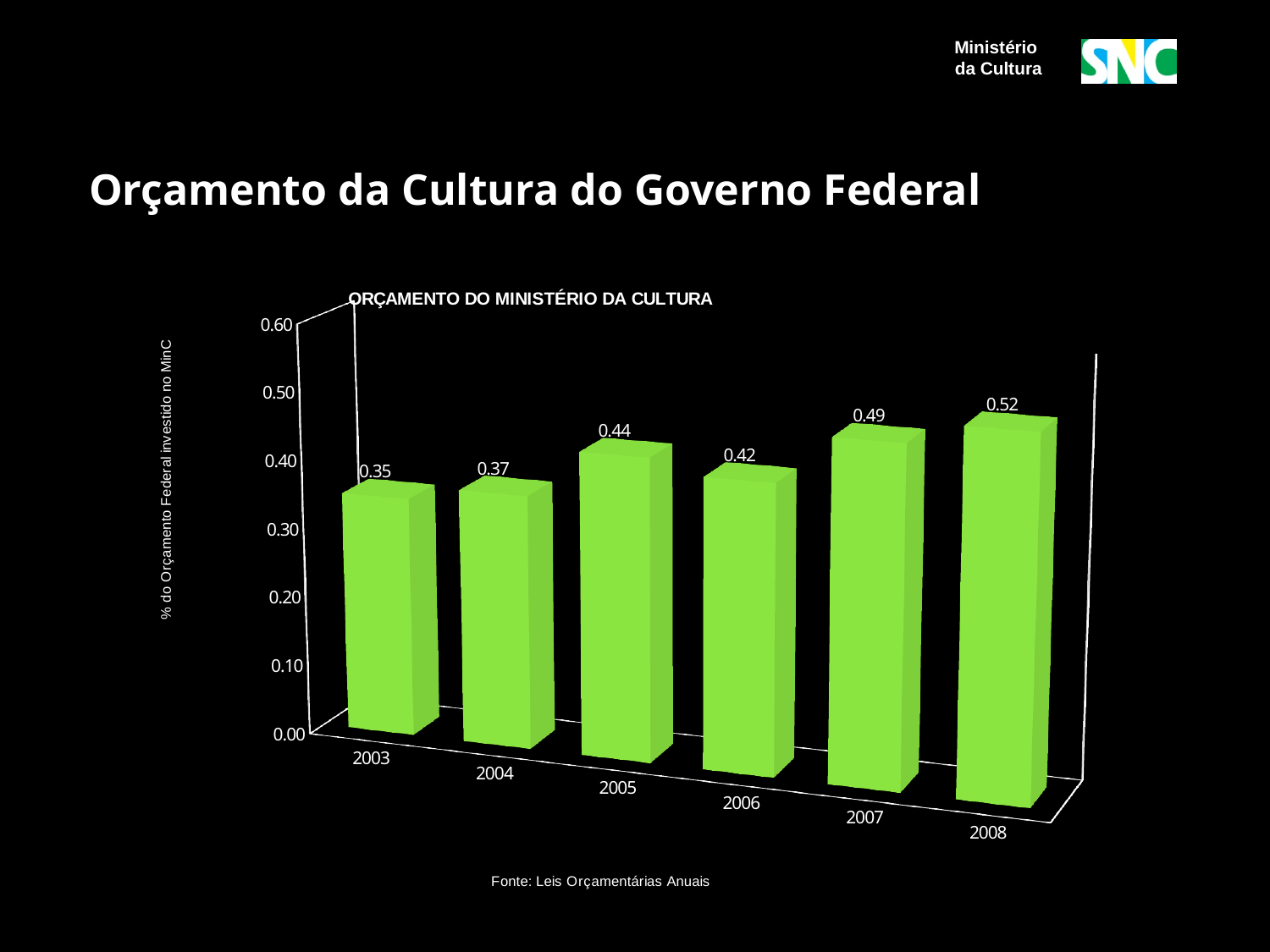
What is the value for 2006? 0.42 What is the title of the chart? ORÇAMENTO DO MINISTÉRIO DA CULTURA What is the difference between the values for 2008 and 2003? 0.17 What is the value for 2008? 0.52 How many years are shown on the chart? 6 What is the difference between the values for 2005 and 2006? 0.02 What kind of chart is shown on the slide? bar chart What is the value for 2003? 0.35 Is the value for 2007 greater or less than 0.40? greater Which is larger, the value for 2005 or the value for 2006? 2005 Which year has the lowest value? 2003 Which year has the highest value? 2008